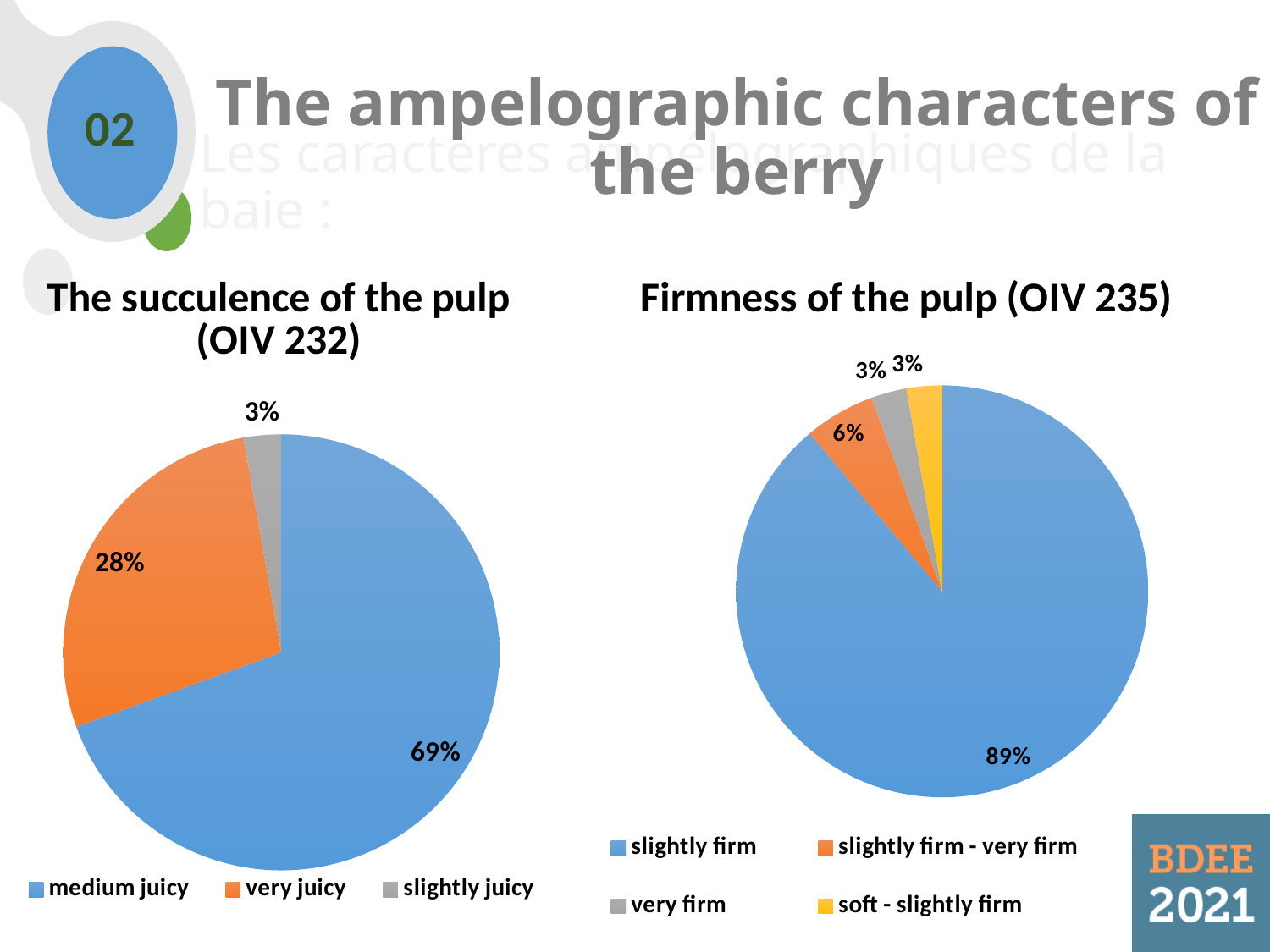
In the chart titled "Firmness of the pulp (OIV 235)", which category has the largest slice? slightly firm In the chart titled "The succulence of the pulp (OIV 232)", what is the difference between the medium juicy and very juicy shares? 41% In the chart titled "The succulence of the pulp (OIV 232)", what share is labelled for very juicy? 28% In the chart titled "Firmness of the pulp (OIV 235)", what colour is the slice for soft - slightly firm? yellow In the chart titled "Firmness of the pulp (OIV 235)", how many categories does the legend list? 4 In the chart titled "The succulence of the pulp (OIV 232)", how many categories does the legend list? 3 What kind of chart is used for "The succulence of the pulp (OIV 232)"? pie chart In the chart titled "Firmness of the pulp (OIV 235)", which is larger: the share for slightly firm - very firm or the share for very firm? slightly firm - very firm In the chart titled "The succulence of the pulp (OIV 232)", which category has the smallest slice? slightly juicy In the chart titled "Firmness of the pulp (OIV 235)", what share is labelled for slightly firm - very firm? 6% In the chart titled "The succulence of the pulp (OIV 232)", what share is labelled for medium juicy? 69% In the chart titled "Firmness of the pulp (OIV 235)", what share is labelled for slightly firm? 89%